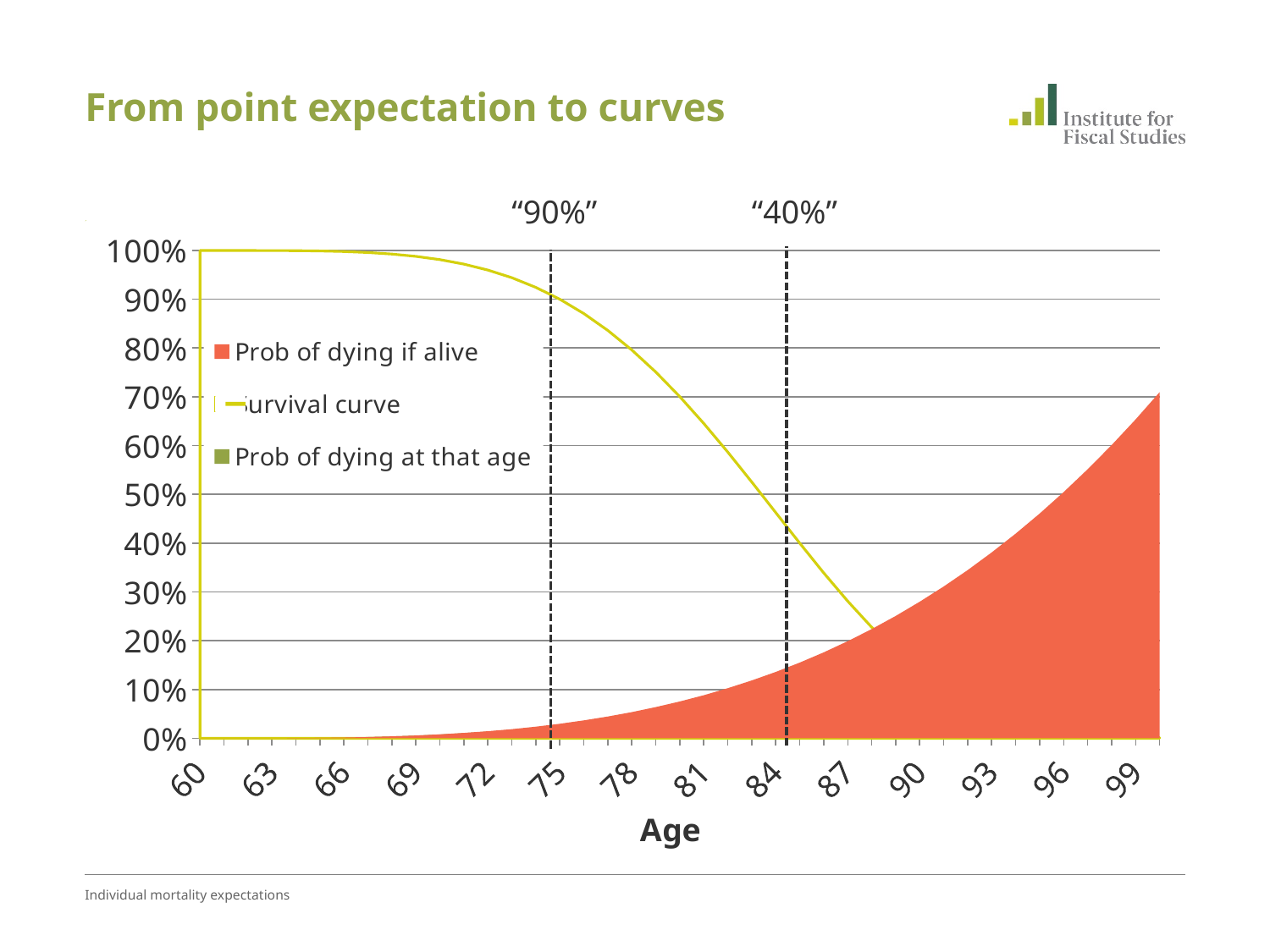
How many series does the legend list? 3 Does the survival curve rise or fall as age increases? Falls What is the label on the x axis of the chart? Age What colour is the survival curve in the chart? Yellow Is the 'Prob of dying if alive' value at age 99 greater or less than 60%? greater What kind of chart is shown on the slide? An area chart (shaded area) combined with a line series Is the survival curve value at age 81 greater or less than 80%? less How many age labels are shown on the x axis? 14 Is the survival curve value at age 72 greater or less than 90%? greater Does the 'Prob of dying if alive' series rise or fall as age increases? Rises At age 84, which is larger: the survival curve or the 'Prob of dying if alive' series? Survival curve